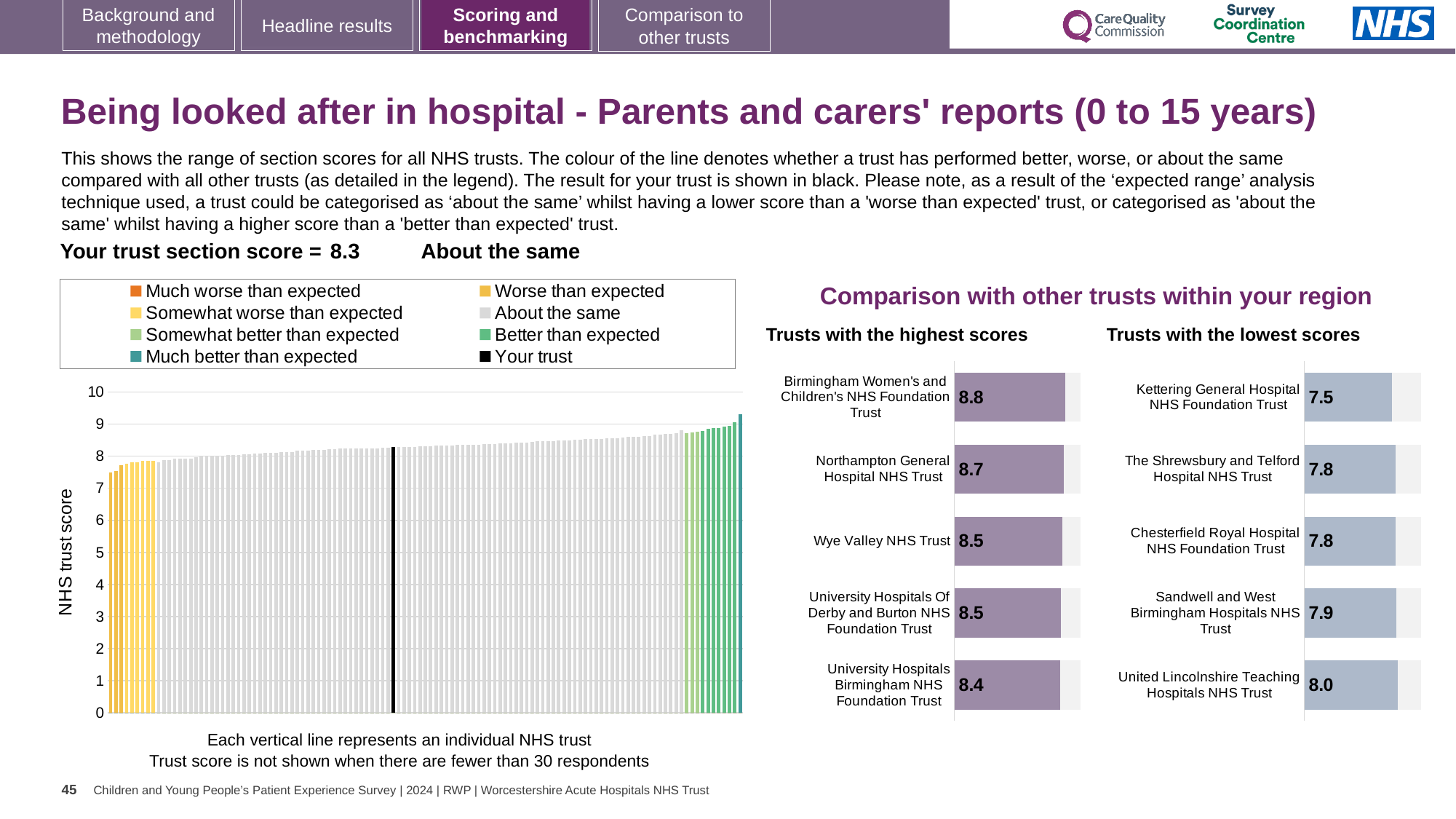
In the main chart on the left, do the trust scores rise or fall from left to right? Rise In the 'Trusts with the highest scores' chart, which has the higher score: Northampton General Hospital NHS Trust or Wye Valley NHS Trust? Northampton General Hospital NHS Trust How many entries does the legend of the main chart on the left list? 8 In the 'Trusts with the highest scores' chart, what is the difference between the scores of Birmingham Women's and Children's NHS Foundation Trust and University Hospitals Birmingham NHS Foundation Trust? 0.4 What kind of chart is the main chart on the left showing the range of section scores for all NHS trusts? Bar chart In the 'Trusts with the lowest scores' chart, which trust has the lowest score? Kettering General Hospital NHS Foundation Trust In the 'Trusts with the lowest scores' chart, what is the score for Kettering General Hospital NHS Foundation Trust? 7.5 In the 'Trusts with the highest scores' chart, what is the score for Birmingham Women's and Children's NHS Foundation Trust? 8.8 In the 'Trusts with the highest scores' chart, which trust has the highest score? Birmingham Women's and Children's NHS Foundation Trust In the 'Trusts with the lowest scores' chart, how many trusts are shown? 5 In the main chart on the left showing the range of section scores, is the value for your trust (the black line) greater or less than 8? greater In the 'Trusts with the lowest scores' chart, what is the difference between the scores of United Lincolnshire Teaching Hospitals NHS Trust and Kettering General Hospital NHS Foundation Trust? 0.5